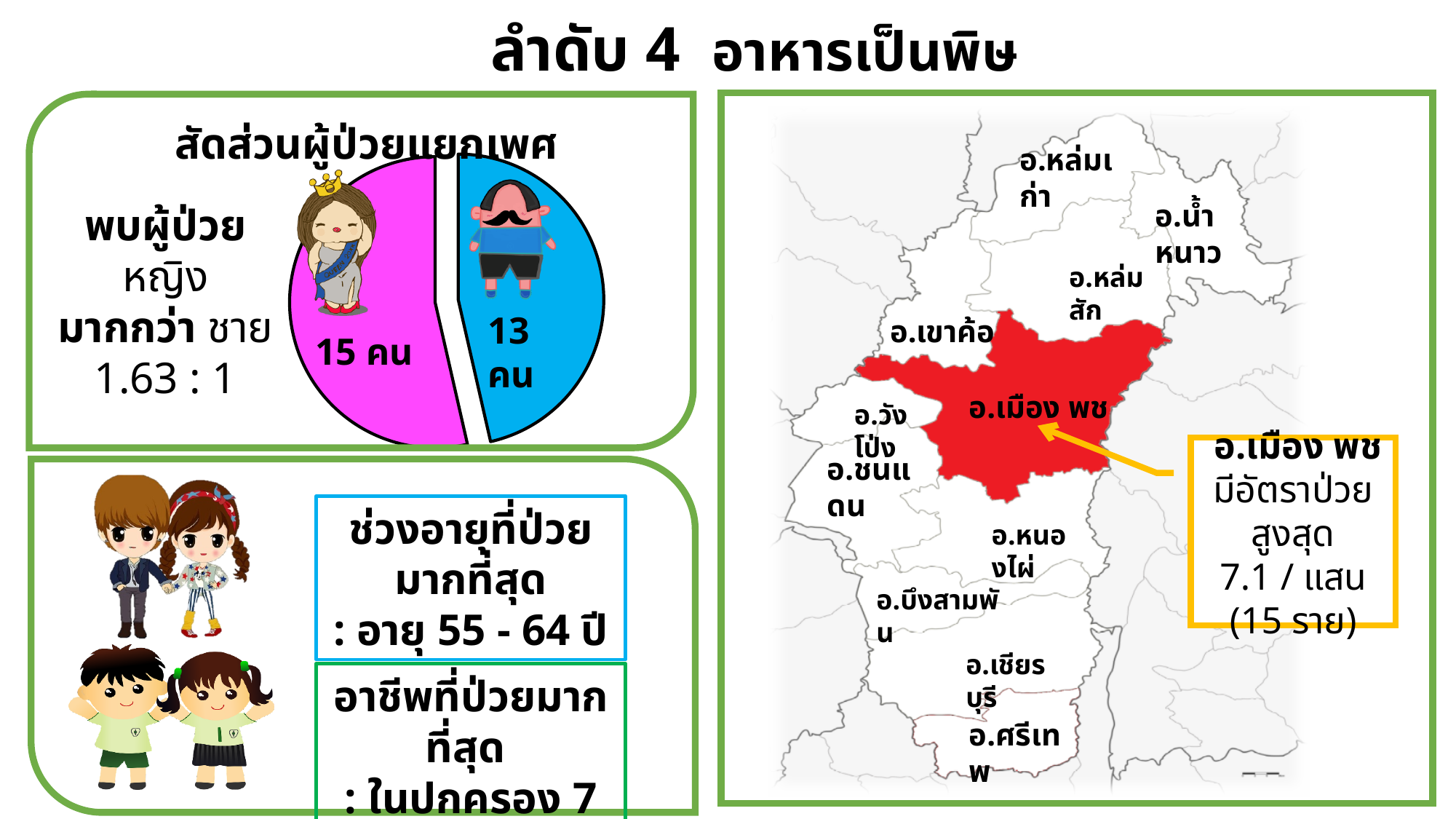
In the pie chart, how many female patients (หญิง) are shown? 15 คน Is the female slice of the pie chart larger or smaller than the male slice? Larger Which group has the larger slice in the pie chart, female (หญิง) or male (ชาย)? หญิง What is the title of the pie chart? สัดส่วนผู้ป่วยแยกเพศ What type of chart is shown in the top-left box of the slide? Pie chart How many slices does the pie chart have? 2 Which group has the smaller slice in the pie chart? ชาย What is the total number of patients represented in the pie chart? 28 คน What colour is the slice representing female patients in the pie chart? Pink What is the difference between the number of female and male patients in the pie chart? 2 คน In the pie chart, how many male patients (ชาย) are shown? 13 คน According to the text next to the pie chart, what is the ratio of female to male patients? 1.63 : 1